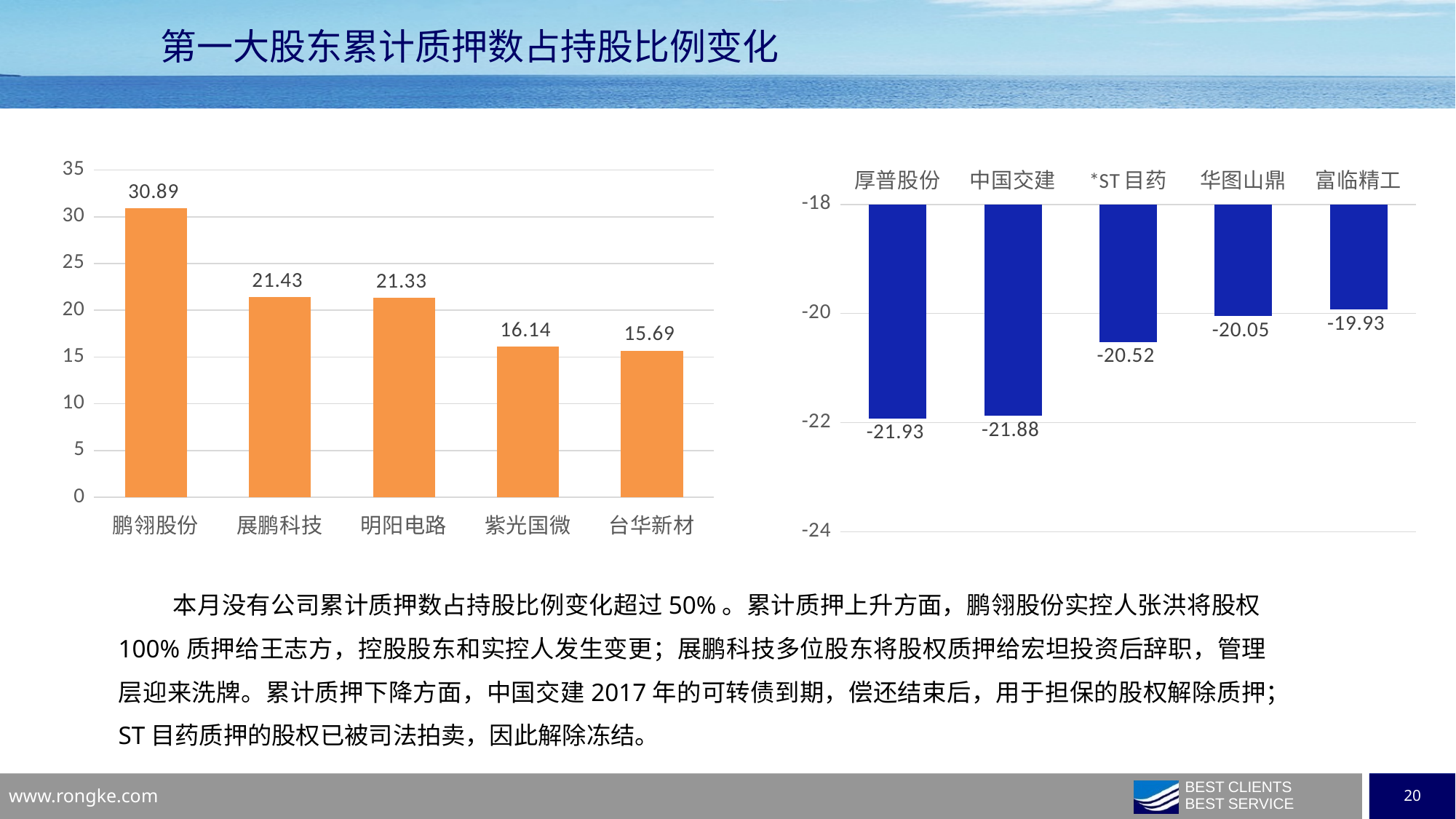
In the right chart (blue bars), what is the value for 富临精工? -19.93 In the right chart (blue bars), what is the difference between the values for 中国交建 and *ST目药? 1.36 In the right chart (blue bars), what is the value for 厚普股份? -21.93 In the left chart (orange bars), what is the value for 紫光国微? 16.14 In the right chart (blue bars), which is larger, the value for 华图山鼎 or the value for *ST目药? 华图山鼎 In the left chart (orange bars), how many categories are shown? 5 In the right chart (blue bars), which category has the lowest (most negative) value? 厚普股份 In the left chart (orange bars), what is the value for 鹏翎股份? 30.89 In the left chart (orange bars), which category has the lowest value? 台华新材 In the left chart (orange bars), do the values rise or fall from left to right? fall What type of chart is the left chart? bar chart In the left chart (orange bars), what is the difference between the values for 鹏翎股份 and 展鹏科技? 9.46